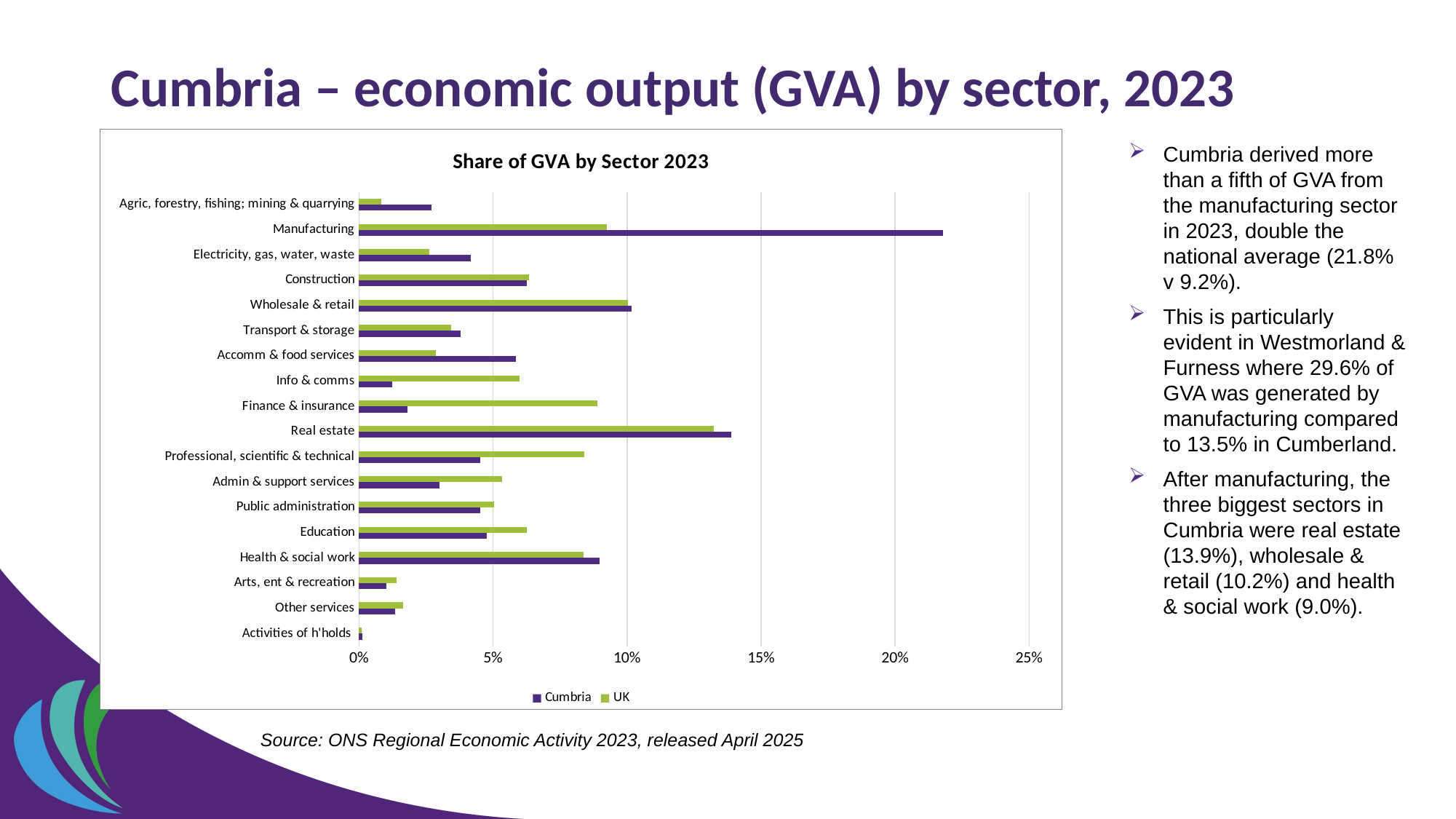
How many series does the chart legend list? 2 Which sector has the highest share of GVA for the UK? Real estate Which sector has the lowest share of GVA for Cumbria? Activities of h'holds What kind of chart is shown on the slide? Bar chart How many sectors are plotted on the chart? 18 What is the UK's share of GVA from manufacturing? 9.2% By how many percentage points does Cumbria's manufacturing share exceed the UK's? 12.6 percentage points For Finance & insurance, which is larger: the Cumbria share or the UK share? UK Is the Cumbria value for Real estate greater or less than 10%? greater What is Cumbria's share of GVA from manufacturing? 21.8% What is the title of the chart? Share of GVA by Sector 2023 Which sector has the highest share of GVA for Cumbria? Manufacturing